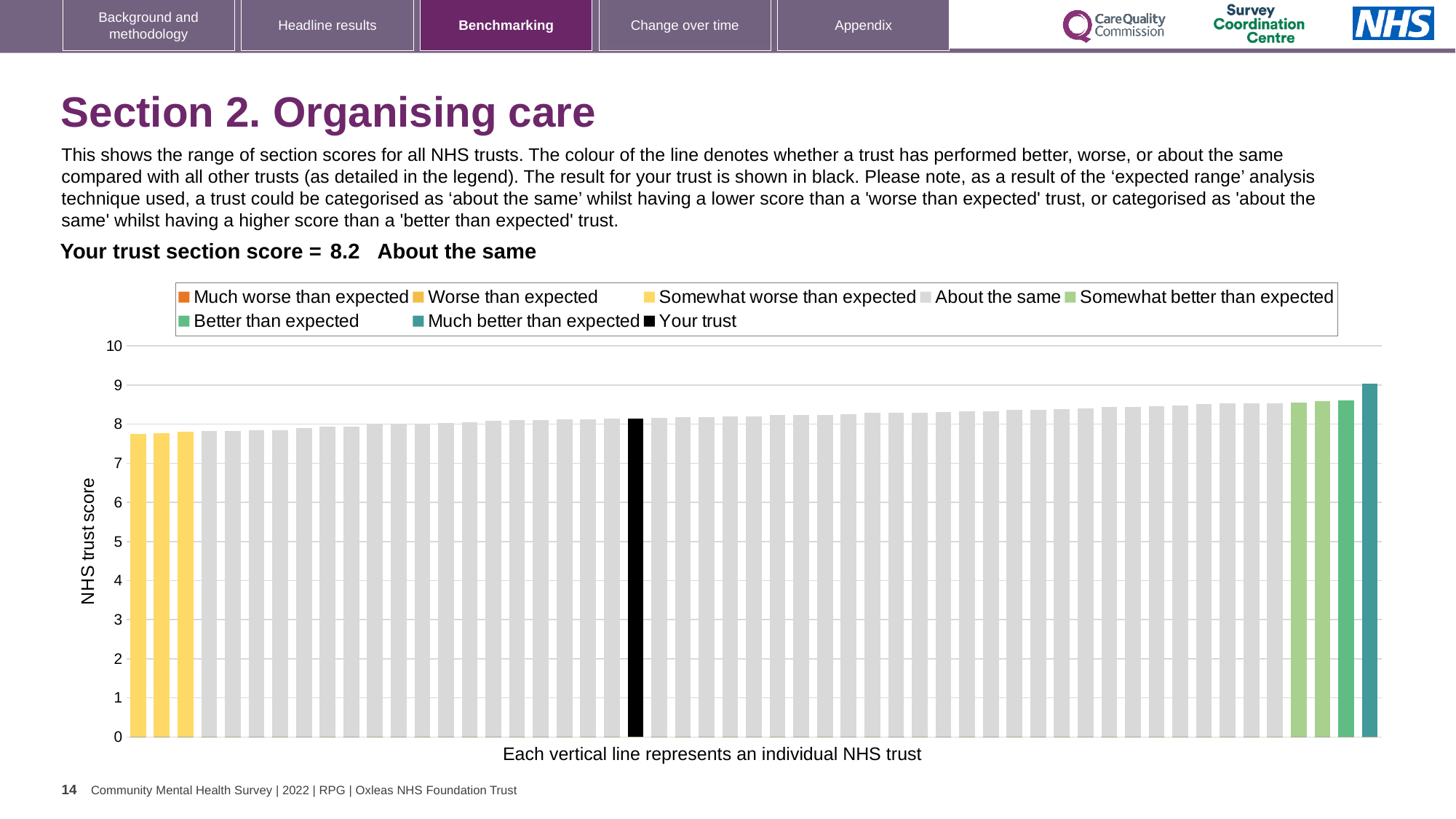
How many entries does the chart legend list? 8 Is the value for your trust (the black bar) greater or less than 5? greater What is the section score for your trust shown on the slide? 8.2 Is the value of the lowest bar in the chart greater or less than 8? less Do the bar values rise or fall from left to right along the x axis? rise What colour is the bar representing your trust? black How many bars are coloured as 'Somewhat worse than expected' (yellow)? 3 What kind of chart is shown on the slide? bar chart Is the value of the highest bar in the chart greater or less than 8? greater What is the label on the y axis of the chart? NHS trust score Which legend category does the tallest bar in the chart belong to? Much better than expected Which category is your trust placed in according to the slide? About the same